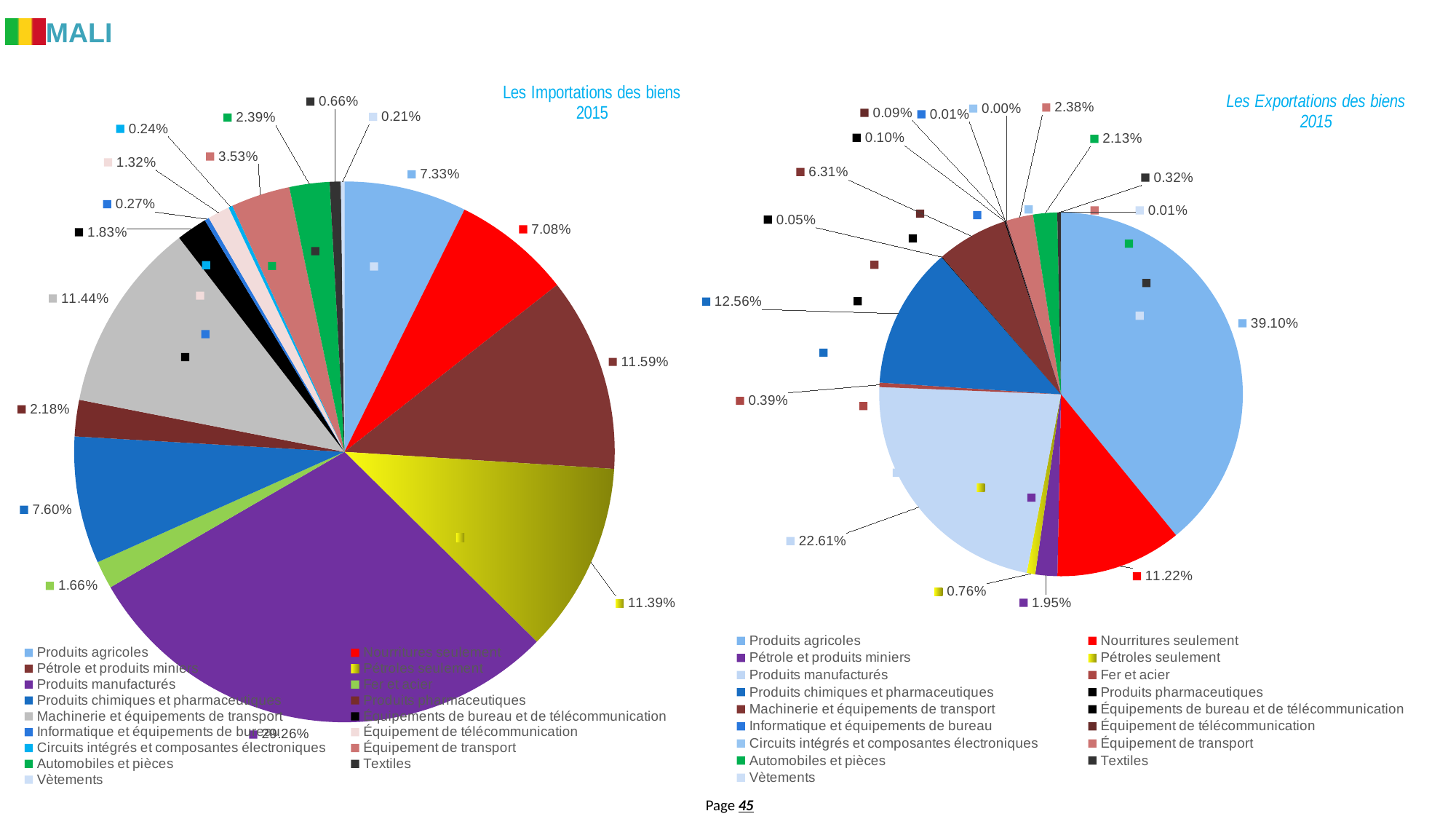
In 'Les Importations des biens 2015', what is the share for Produits manufacturés? 29.26% In 'Les Exportations des biens 2015', what is the share for Produits agricoles? 39.10% How many entries does the legend of 'Les Exportations des biens 2015' list? 17 In 'Les Importations des biens 2015', which category has the largest share? Produits manufacturés In 'Les Importations des biens 2015', which is larger: Produits agricoles or Produits chimiques et pharmaceutiques? Produits chimiques et pharmaceutiques In 'Les Importations des biens 2015', what is the share for Machinerie et équipements de transport? 11.44% In 'Les Exportations des biens 2015', what is the share for Produits manufacturés? 22.61% What is the title of the pie chart on the right side of the slide? Les Exportations des biens 2015 In 'Les Exportations des biens 2015', what is the difference between Produits chimiques et pharmaceutiques and Nourritures seulement? 1.34% In 'Les Importations des biens 2015', what is the difference between Pétrole et produits miniers and Pétroles seulement? 0.20% In 'Les Exportations des biens 2015', which category has the largest share? Produits agricoles What kind of chart is 'Les Importations des biens 2015'? Pie chart